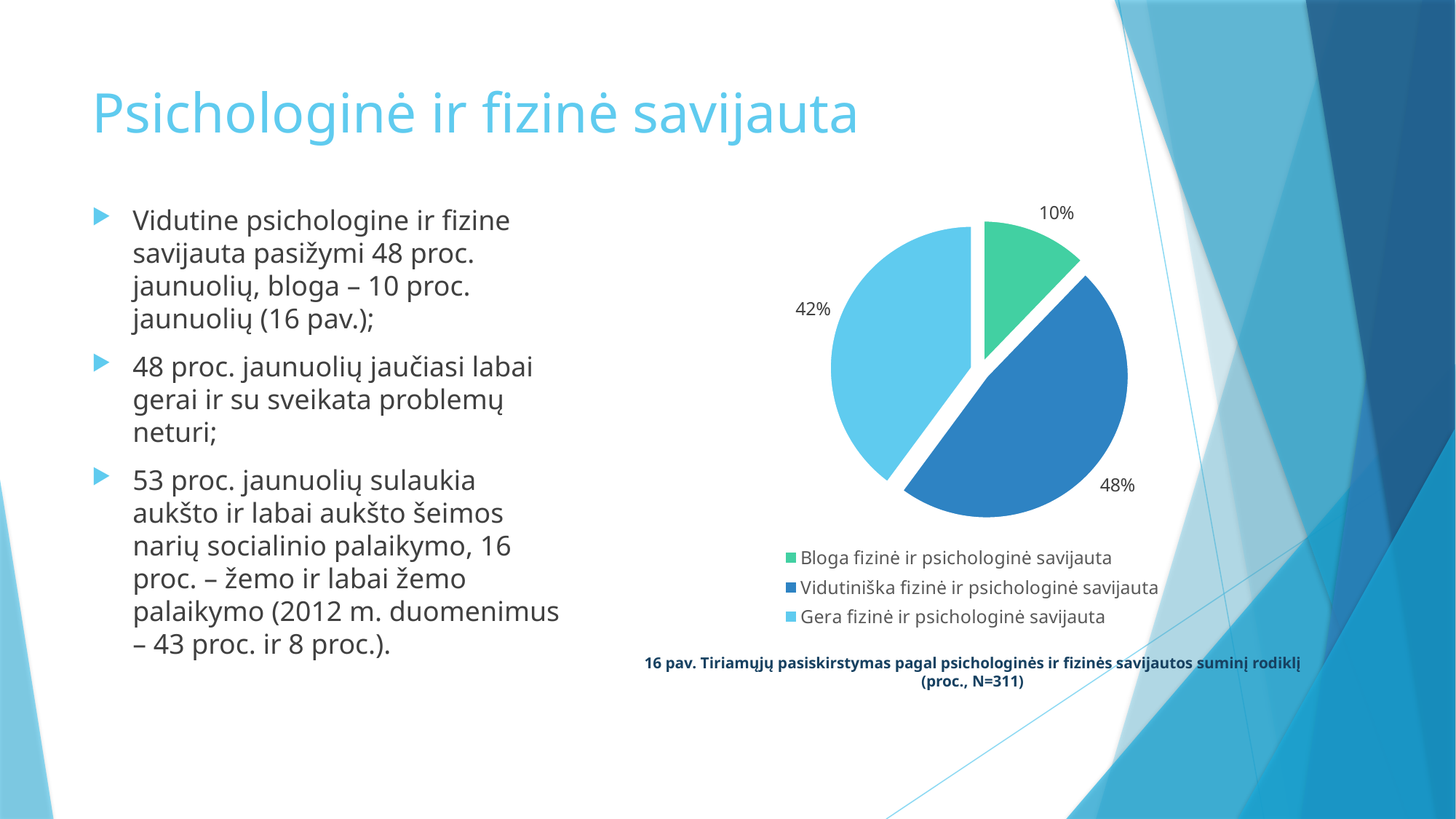
What is the difference in percentage points between the "Vidutiniška" slice and the "Gera" slice? 6 What kind of chart is shown on the slide? pie chart What share of the pie is labelled "Bloga fizinė ir psichologinė savijauta"? 10% What share of the pie is labelled "Gera fizinė ir psichologinė savijauta"? 42% How many slices does the pie chart have? 3 What is the difference in percentage points between the "Gera" slice and the "Bloga" slice? 32 What share of the pie is labelled "Vidutiniška fizinė ir psichologinė savijauta"? 48% How many entries does the chart legend list? 3 Which slice is larger: "Gera fizinė ir psichologinė savijauta" or "Bloga fizinė ir psichologinė savijauta"? Gera fizinė ir psichologinė savijauta What sample size (N) is given in the chart caption? N=311 Which category has the smallest slice of the pie? Bloga fizinė ir psichologinė savijauta Which category has the largest slice of the pie? Vidutiniška fizinė ir psichologinė savijauta